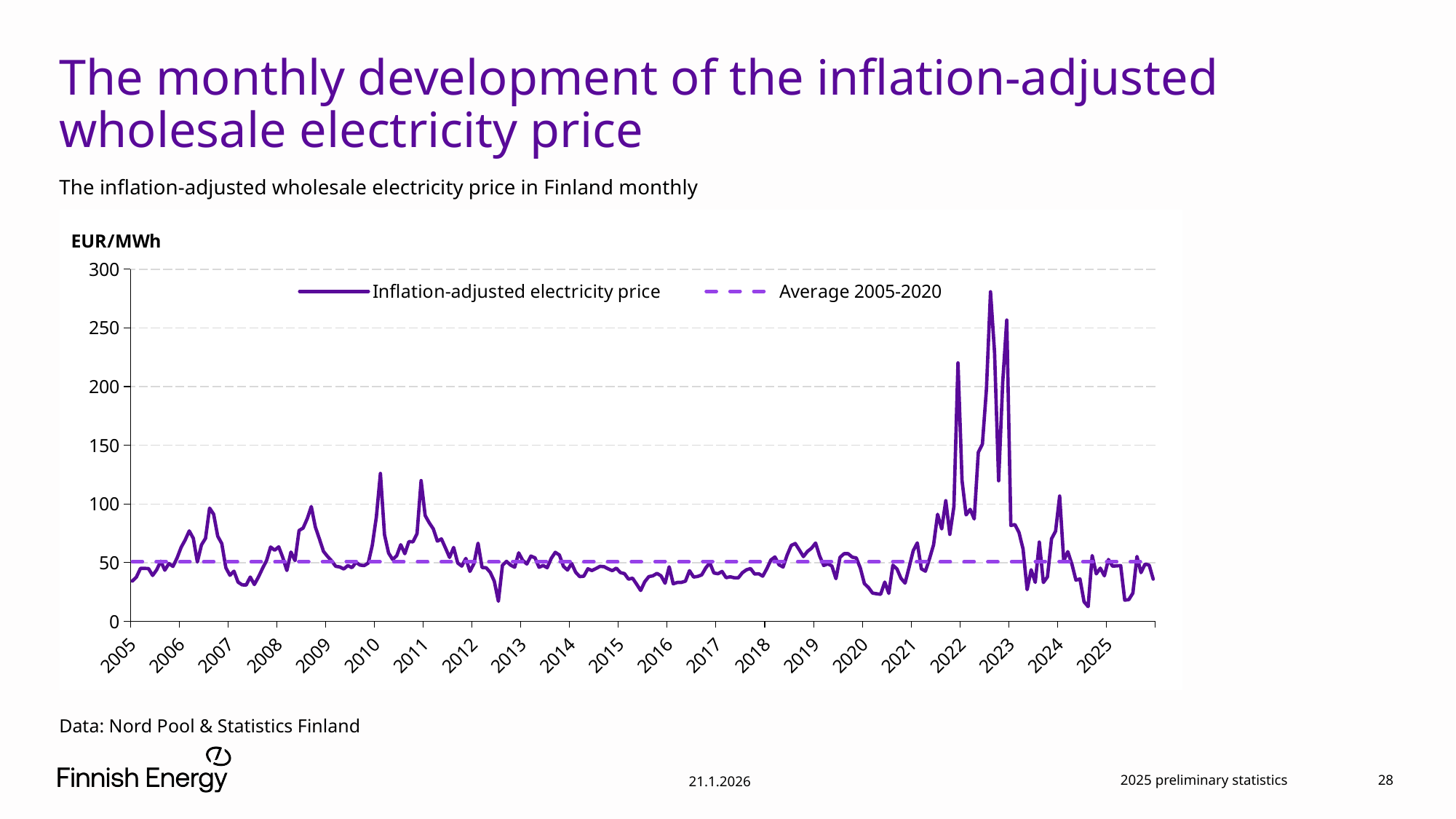
What unit is shown on the vertical axis of the chart? EUR/MWh Is the peak of the inflation-adjusted electricity price in 2010 greater or less than 150? less Is the Average 2005-2020 line greater or less than 100? less What kind of chart is shown on the slide? line chart What are the two entries in the chart legend? Inflation-adjusted electricity price; Average 2005-2020 From the 2022 peak to 2025, does the inflation-adjusted electricity price generally rise or fall? fall How many year labels are shown on the x axis? 21 Which is higher: the peak of the inflation-adjusted electricity price in 2022 or the peak in 2010? 2022 In which year does the inflation-adjusted electricity price reach its highest peak? 2022 How many series does the legend list? 2 Is the highest peak of the inflation-adjusted electricity price in 2022 greater or less than 250? greater